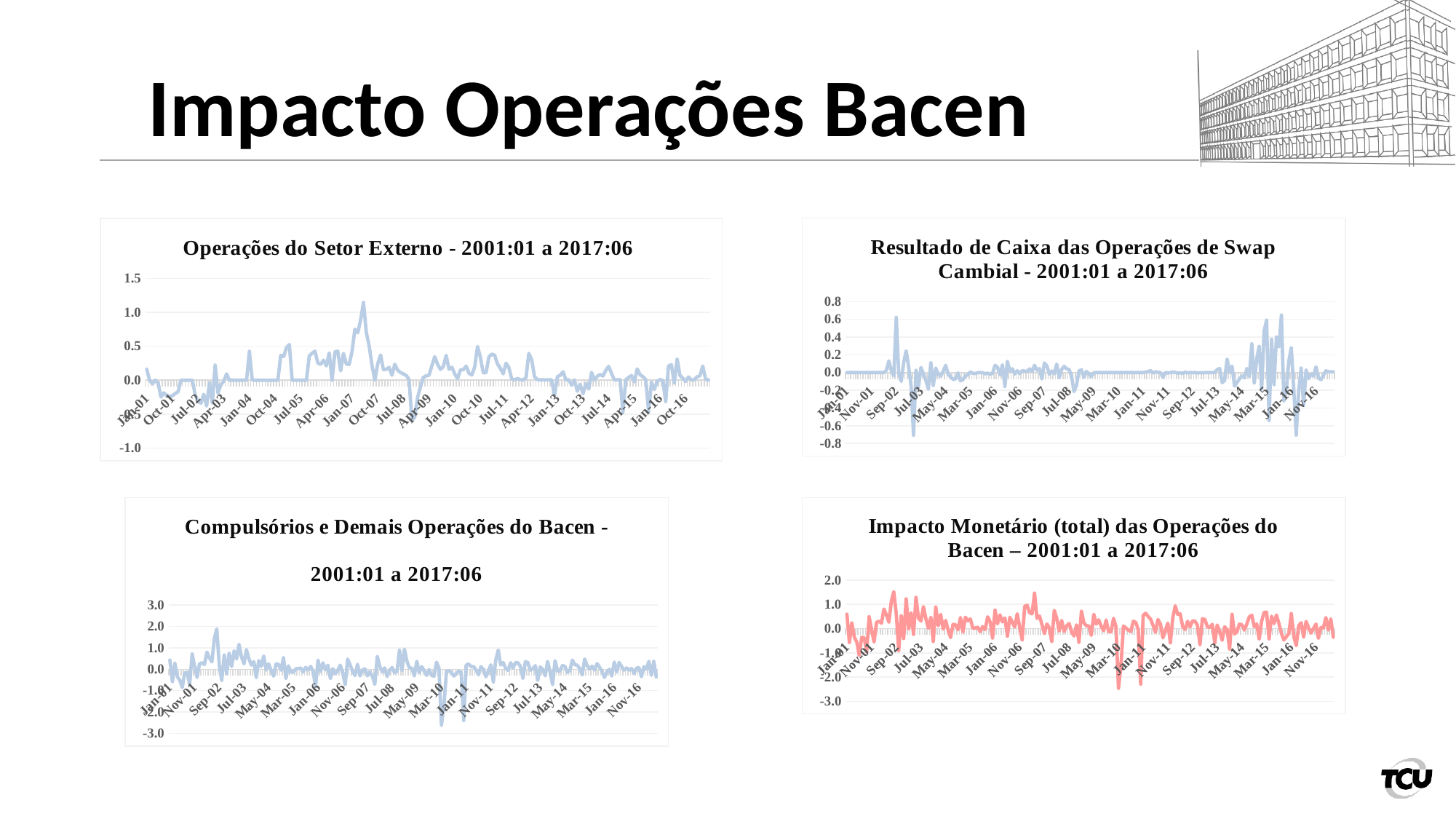
In the 'Impacto Monetário (total) das Operações do Bacen' chart, is the peak value around Sep-02 greater or less than 1.0? greater In the 'Resultado de Caixa das Operações de Swap Cambial' chart, is the highest value around Jan-16 greater or less than 0.4? greater In the 'Impacto Monetário (total) das Operações do Bacen' chart, is the lowest value around Mar-10 greater or less than -2.0? less What is the title of the bottom-right chart? Impacto Monetário (total) das Operações do Bacen – 2001:01 a 2017:06 How many charts are shown on the slide? 4 What kind of chart is 'Operações do Setor Externo - 2001:01 a 2017:06'? line chart In the 'Impacto Monetário (total) das Operações do Bacen' chart, what colour is the plotted line? red What kind of chart is 'Impacto Monetário (total) das Operações do Bacen – 2001:01 a 2017:06'? line chart